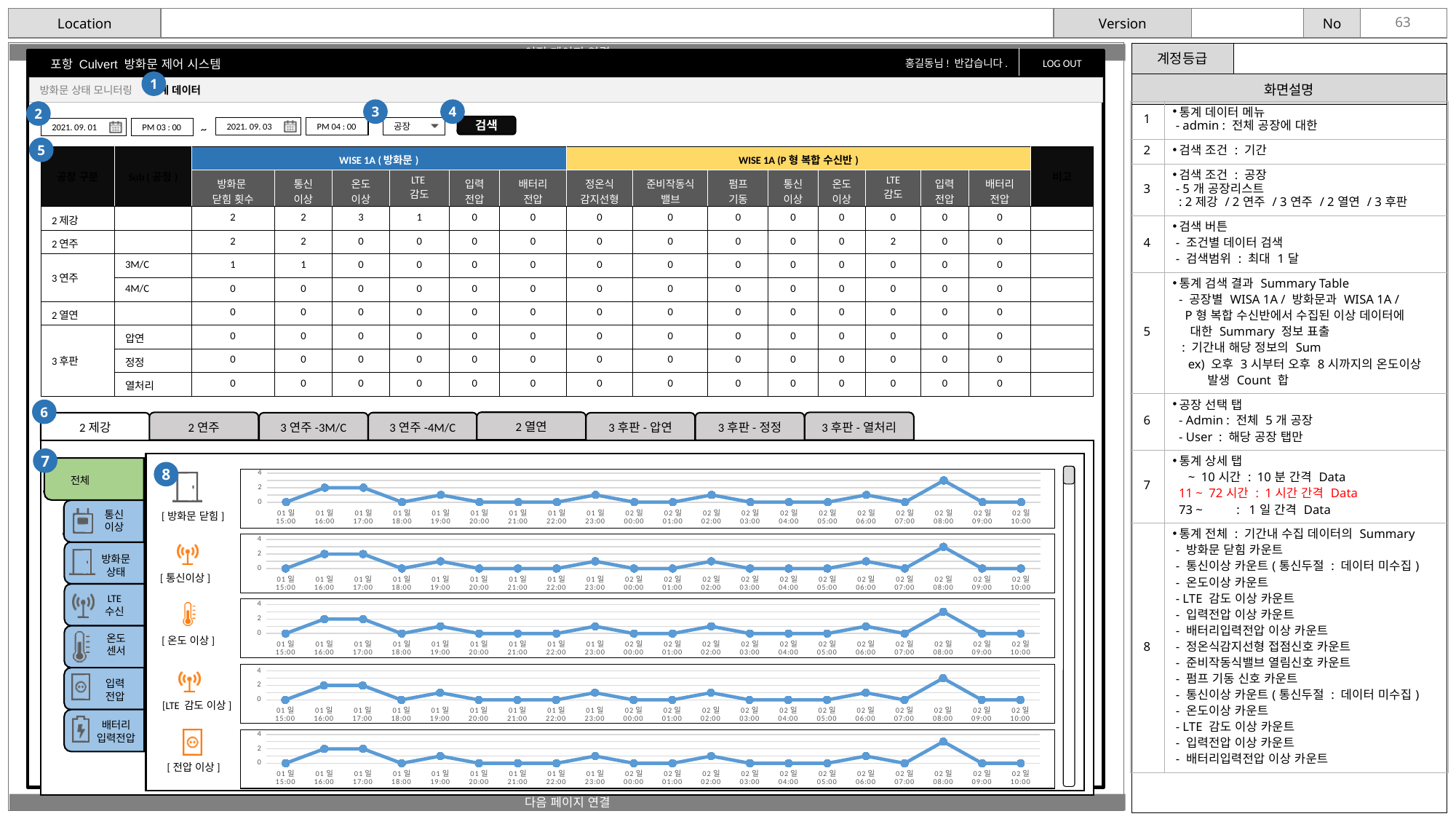
How many time points are plotted along the x axis of the [방화문 닫힘] chart? 20 What kind of chart is shown in the [방화문 닫힘] panel? line chart How many line charts are shown on the slide? 5 What is the first x-axis label on the [방화문 닫힘] chart? 01일 15:00 In the [방화문 닫힘] chart, is the value at 02일 08:00 greater or less than 2? greater In the [통신이상] chart, is the value at 01일 15:00 greater or less than 2? less In the [전압 이상] chart, which is larger: the value at 02일 08:00 or the value at 02일 09:00? 02일 08:00 In the [전압 이상] chart, is the value at 02일 02:00 greater or less than 2? less In the [온도 이상] chart, which is larger: the value at 02일 08:00 or the value at 01일 18:00? 02일 08:00 What is the label of the bottom-most line chart on the slide? [전압 이상] In the [방화문 닫힘] chart, at which time point is the value highest? 02일 08:00